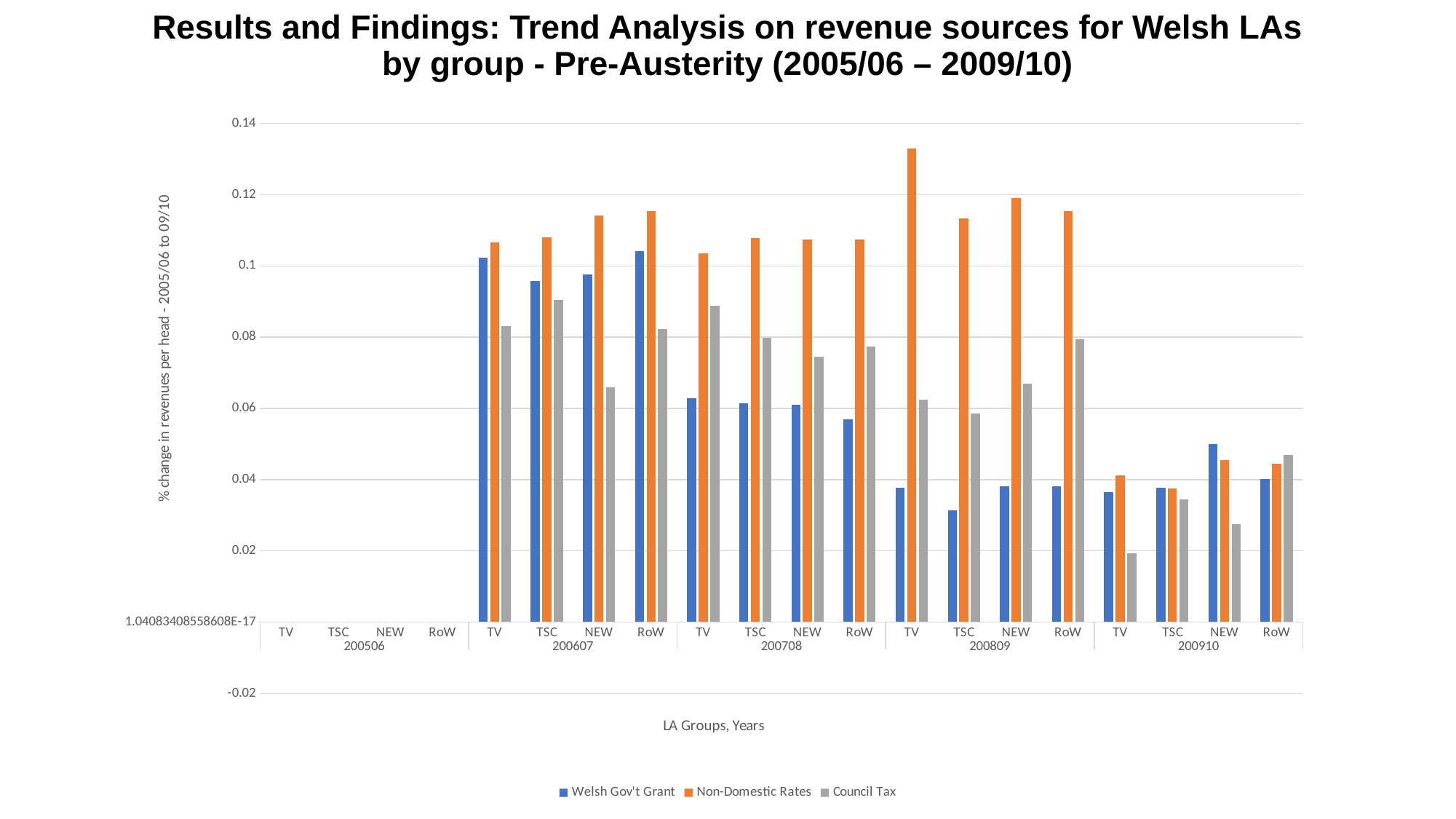
Is the Non-Domestic Rates value for TV in 200809 greater or less than 0.12? greater How many series does the legend list? 3 Does the Welsh Gov't Grant value for TV rise or fall from 200607 to 200910? fall Which year and LA group has the highest Non-Domestic Rates bar? TV, 200809 What kind of chart is shown on the slide? Bar chart Is the Welsh Gov't Grant value for TSC in 200809 greater or less than 0.04? less Is the Council Tax value for TV in 200910 greater or less than 0.04? less For NEW in 200910, which is larger: Welsh Gov't Grant or Council Tax? Welsh Gov't Grant How many LA group categories are shown within each year on the x axis? 4 How many year groups are shown along the x axis? 5 Which year and LA group has the lowest Council Tax bar among those with visible bars? TV, 200910 For TV in 200809, which is larger: Non-Domestic Rates or Welsh Gov't Grant? Non-Domestic Rates